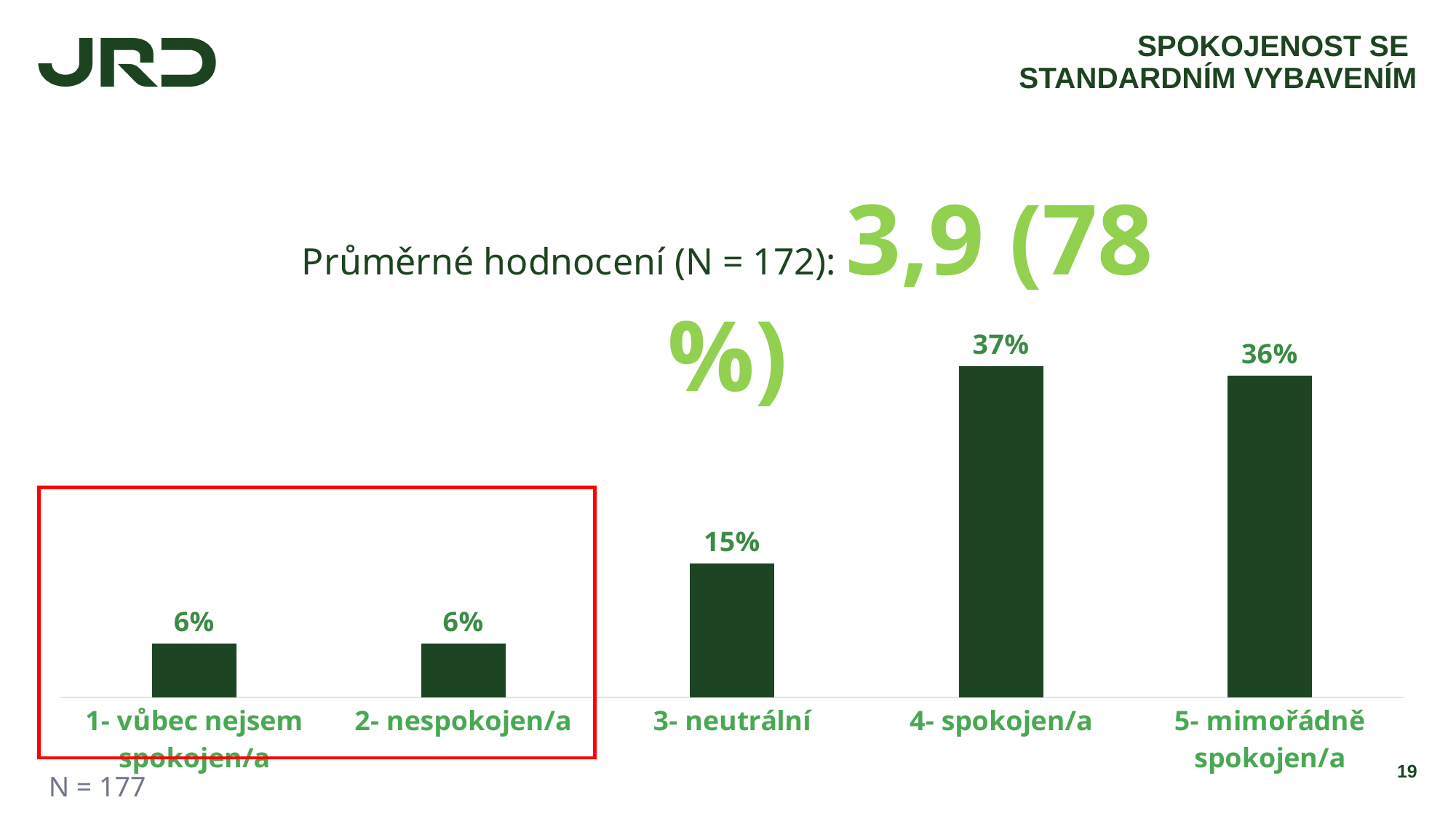
What is the combined value of "4- spokojen/a" and "5- mimořádně spokojen/a"? 73% Which two categories are enclosed by the red box? 1- vůbec nejsem spokojen/a and 2- nespokojen/a What is the difference between the values for "4- spokojen/a" and "3- neutrální"? 22% Which is larger, the value for "3- neutrální" or the value for "2- nespokojen/a"? 3- neutrální Which category has the highest value? 4- spokojen/a What is the value for "4- spokojen/a"? 37% What is the value for "1- vůbec nejsem spokojen/a"? 6% What is the value for "3- neutrální"? 15% What kind of chart is shown on the slide? Bar chart How many categories are shown on the x axis? 5 What is the difference between the values for "5- mimořádně spokojen/a" and "2- nespokojen/a"? 30% What is the value for "5- mimořádně spokojen/a"? 36%